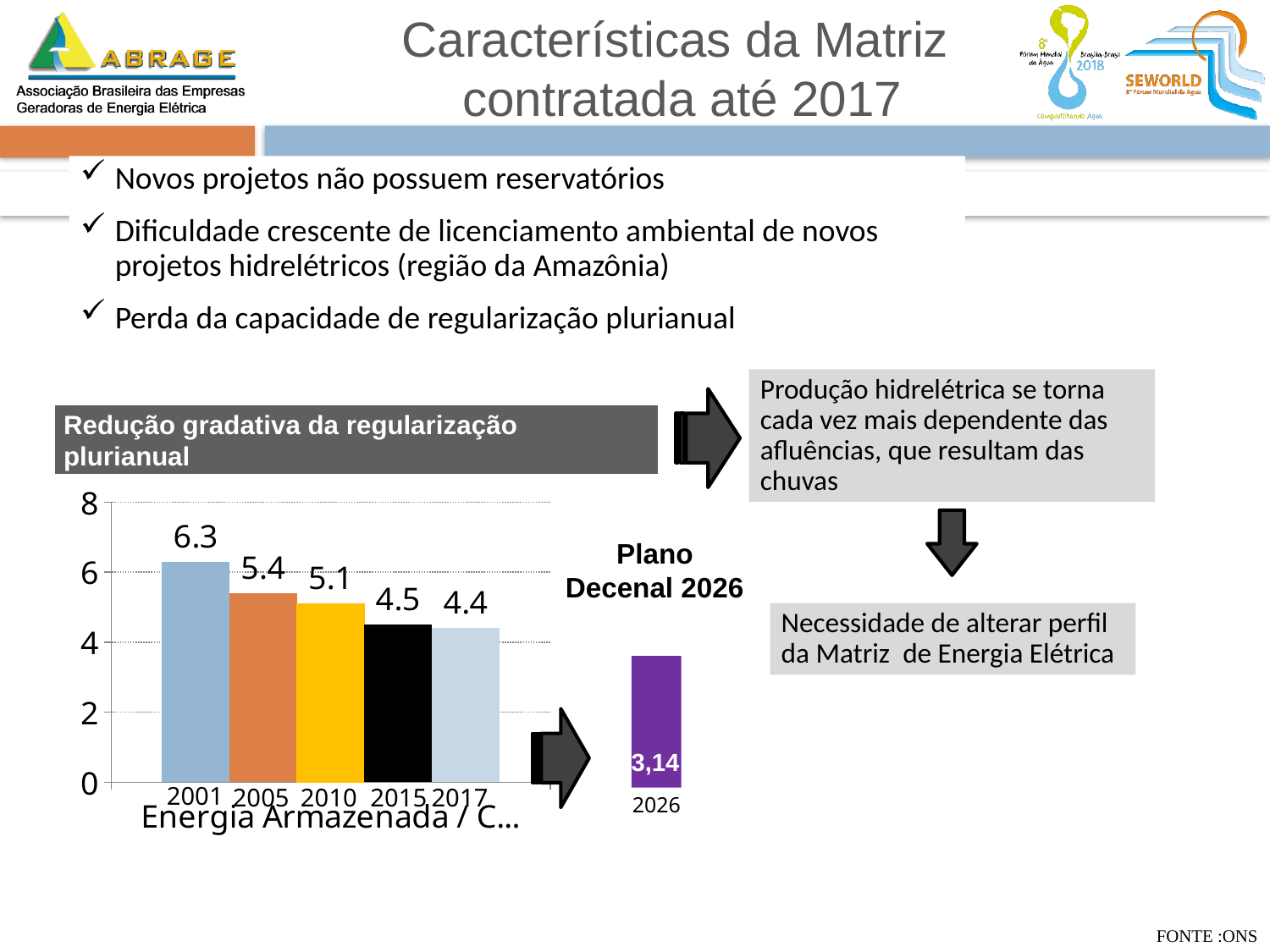
How many years are shown as bars in the main bar chart? 5 What is the difference between the values for 2005 and 2015 in the bar chart? 0.9 What kind of chart is shown on the slide? bar chart Which year has the lowest value in the bar chart? 2017 What is the value for 2001 in the bar chart? 6.3 Which year has the highest value in the bar chart? 2001 Which is larger in the bar chart, the value for 2005 or the value for 2015? 2005 What is the value for 2017 in the bar chart? 4.4 Is the value for 2010 in the bar chart greater or less than 4? greater Do the values in the bar chart rise or fall from 2001 to 2017? fall What is the value for 2010 in the bar chart? 5.1 What is the difference between the values for 2001 and 2017 in the bar chart? 1.9